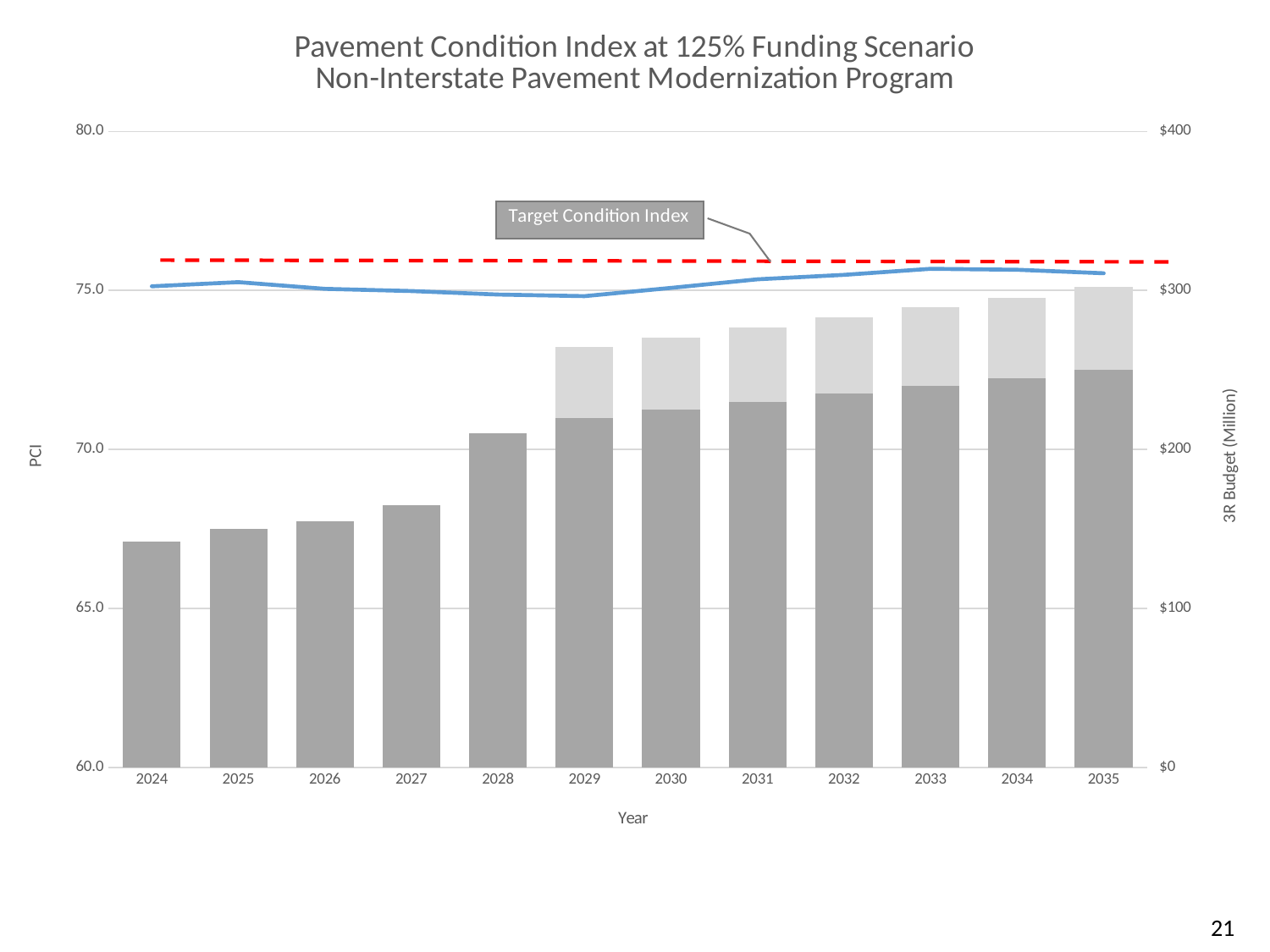
Is the bar value for 2027 greater or less than $100 million? greater In how many years does the stacked bar include a light gray segment on top? 7 Which year has the shortest bar? 2024 What kind of chart is shown on the slide? A bar chart combined with a line chart What does the red dashed line represent? Target Condition Index Do the bar values generally rise or fall from 2024 to 2035? rise Which year has a taller stacked bar, 2026 or 2030? 2030 Which year has the tallest stacked bar? 2035 Is the total stacked bar value for 2035 greater or less than $200 million? greater Is the total bar value for 2024 greater or less than $200 million? less What is the label of the right-hand vertical axis? 3R Budget (Million) How many years are shown along the x axis? 12